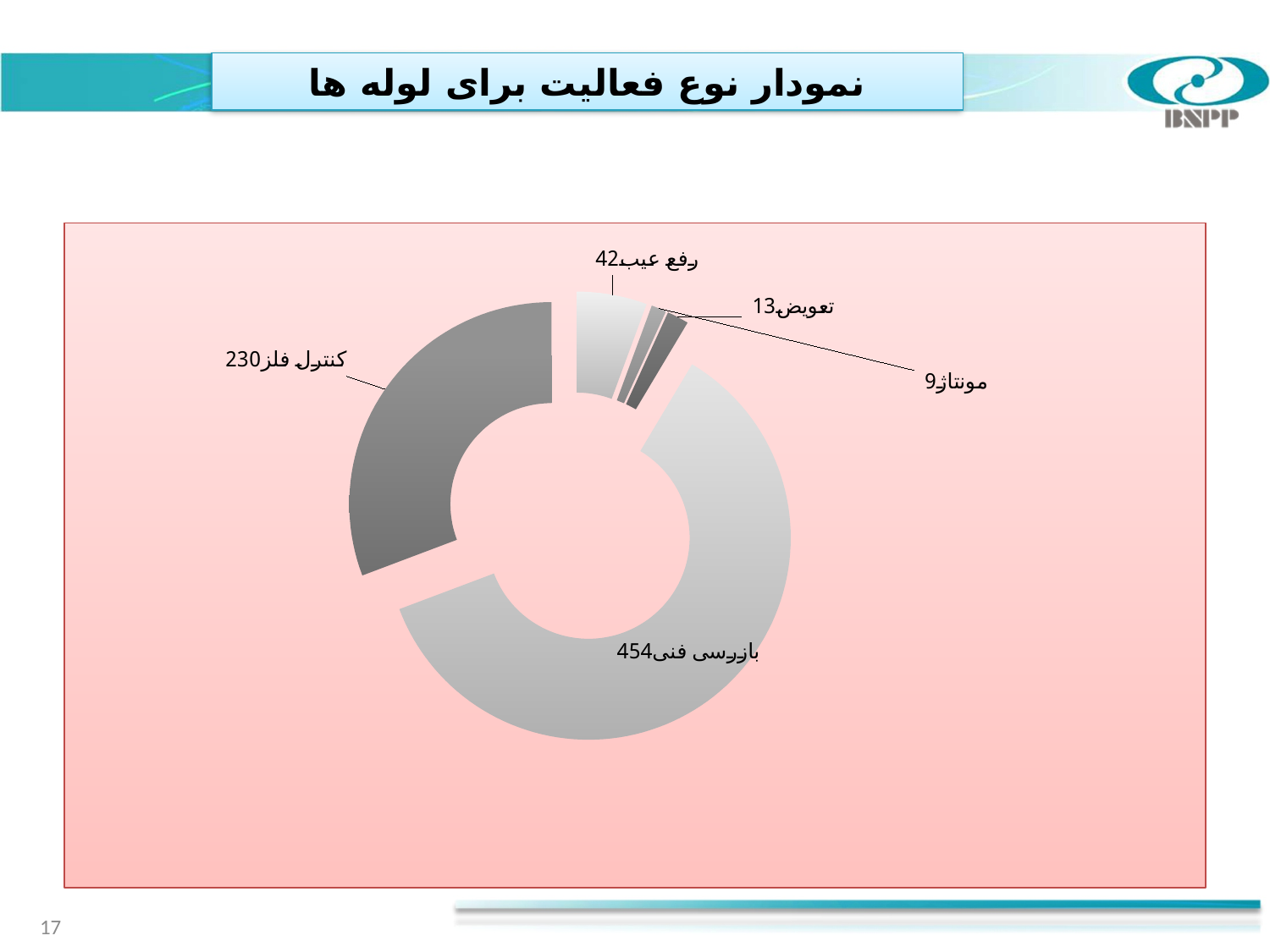
What kind of chart is shown on the slide? Doughnut chart What is the value for رفع عیب in the chart? 42 What is the value for تعویض in the chart? 13 What is the value for کنترل فلز in the chart? 230 What is the title of the slide containing the chart? نمودار نوع فعالیت برای لوله ها What is the value for بازرسی فنی in the chart? 454 What is the difference between the values for بازرسی فنی and کنترل فلز? 224 Which is larger, the value for رفع عیب or the value for تعویض? رفع عیب How many categories are shown in the chart? 5 What is the value for مونتاژ in the chart? 9 Which category has the lowest value in the chart? مونتاژ Which category has the highest value in the chart? بازرسی فنی